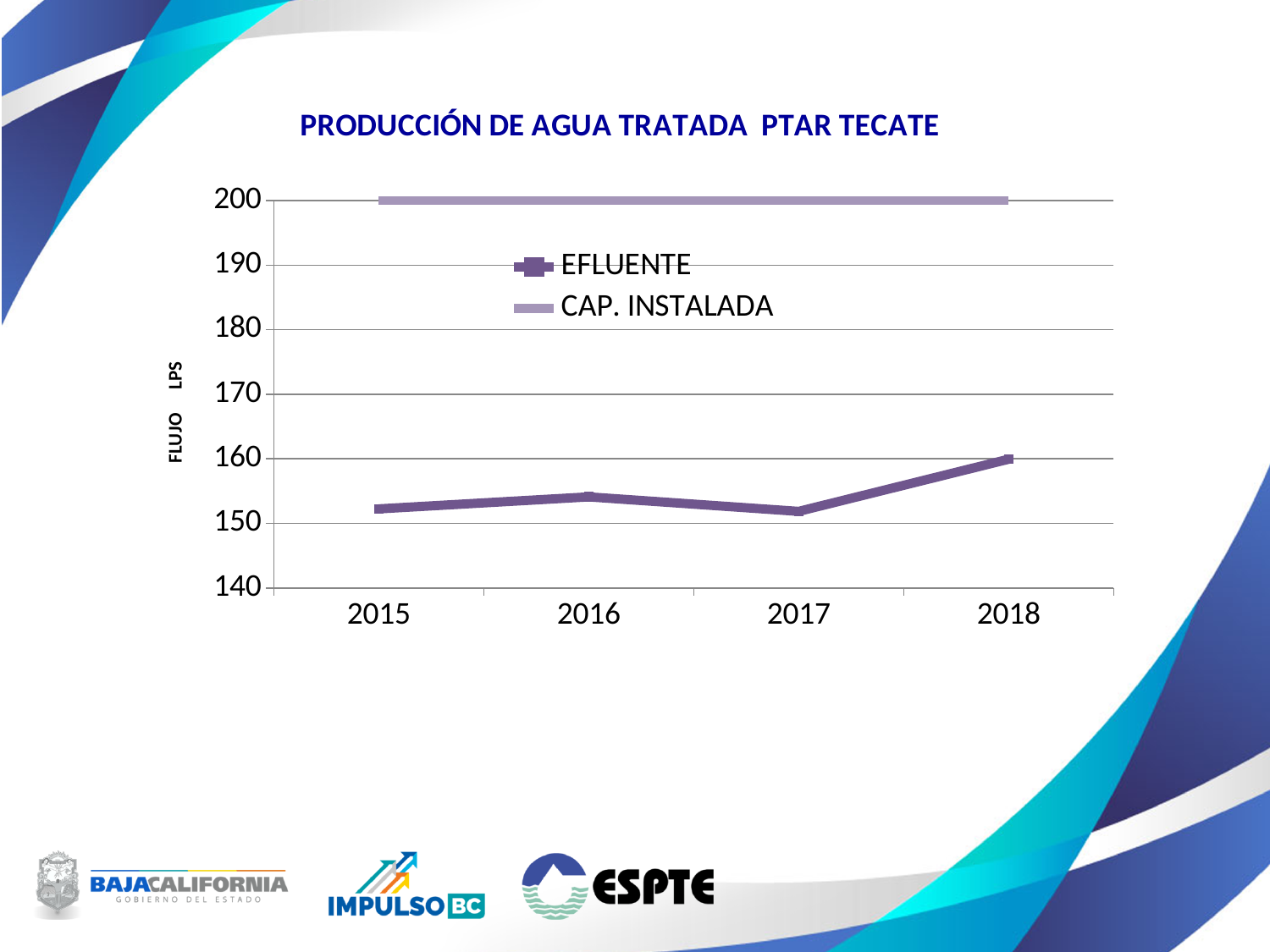
How many series does the legend list? 2 Is the EFLUENTE value for 2018 greater or less than 155? greater Does the EFLUENTE line rise or fall from 2017 to 2018? rise What kind of chart is shown on the slide? Line chart Is the EFLUENTE value for 2015 greater or less than 160? less What is the title of the chart? PRODUCCIÓN DE AGUA TRATADA PTAR TECATE In which year is the EFLUENTE value highest? 2018 What label is shown on the y axis? FLUJO LPS What is the value of CAP. INSTALADA in 2016? 200 How many years are shown on the x axis? 4 Which is larger, the EFLUENTE value for 2018 or for 2015? 2018 Is the EFLUENTE value for 2017 greater or less than 150? greater